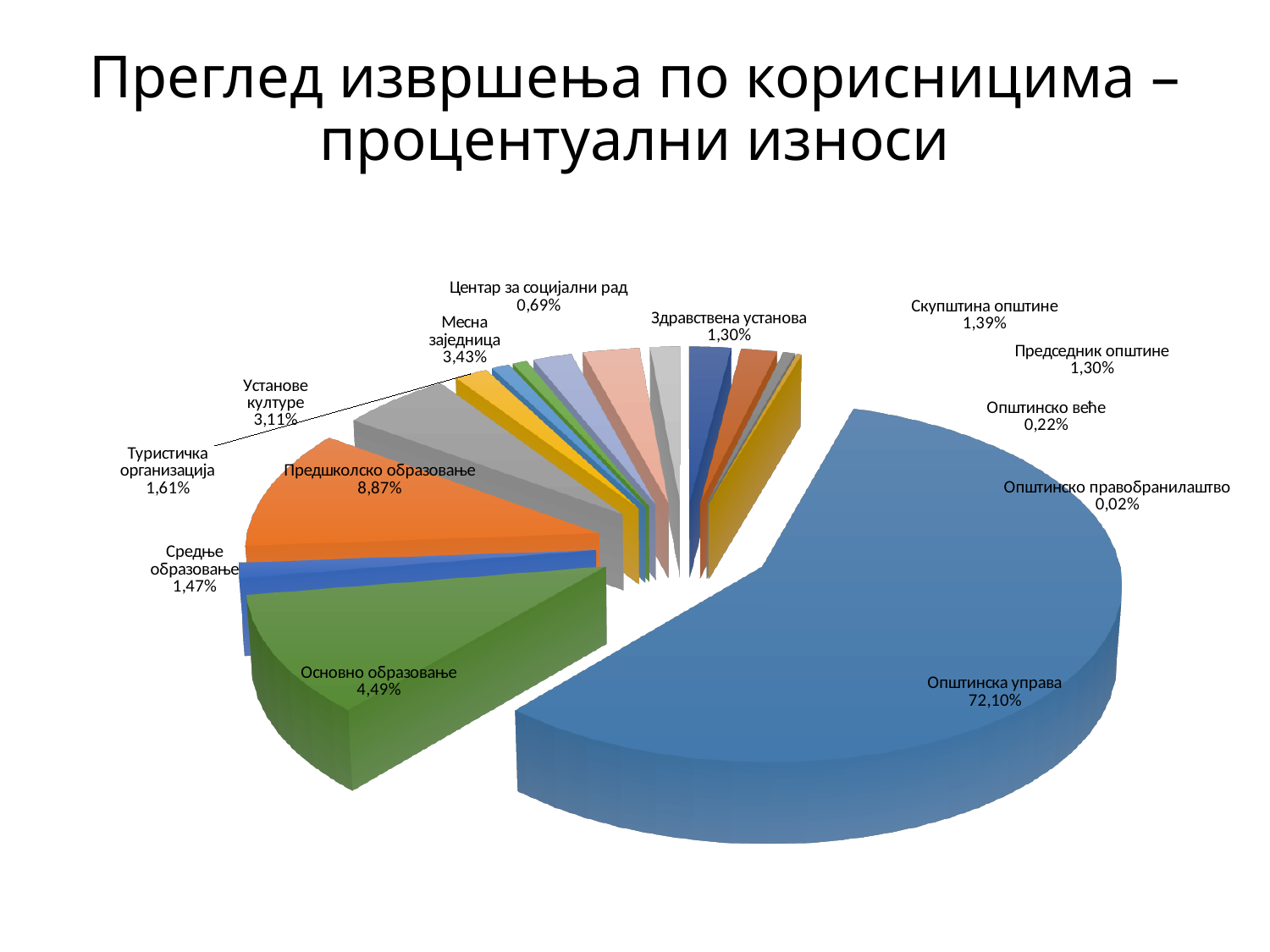
What is the value shown for Општинска управа? 72,10% Which category has the smallest share of the pie? Општинско правобранилаштво How many categories are shown in the pie chart? 15 What is the value shown for Центар за социјални рад? 0,69% What is the title of the slide? Преглед извршења по корисницима – процентуални износи What is the difference between the values for Предшколско образовање and Основно образовање? 4,38% What is the value shown for Предшколско образовање? 8,87% What is the difference between the values for Скупштина општине and Општинско веће? 1,17% What kind of chart is shown on the slide? Pie chart What is the value shown for Месна заједница? 3,43% Which is larger, the value for Установе културе or the value for Туристичка организација? Установе културе Which category has the largest share of the pie? Општинска управа